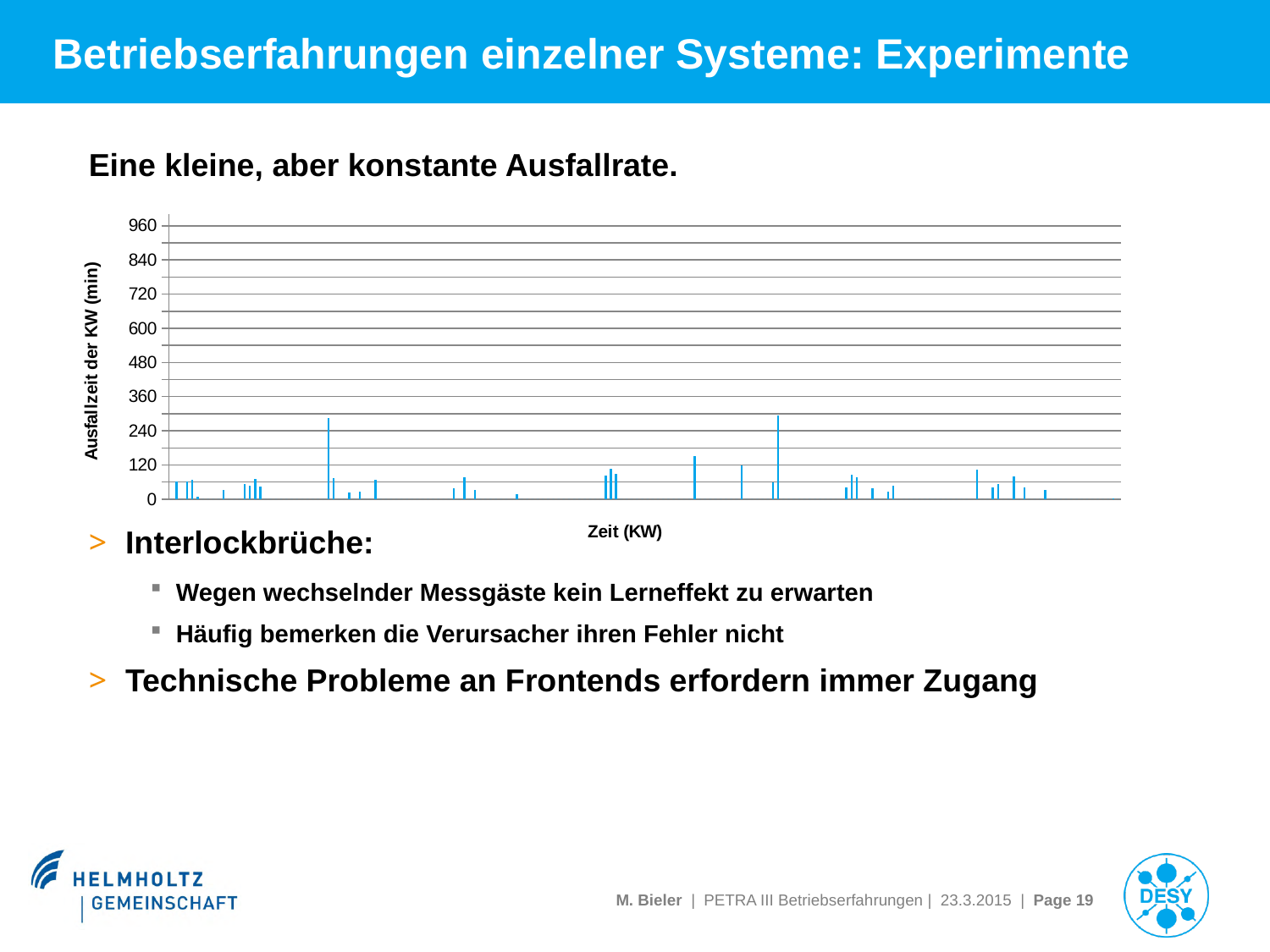
What kind of chart is shown on the slide? bar chart Are most of the bars in the chart greater or less than 120? less What is the title of the vertical axis of the chart? Ausfallzeit der KW (min) Is the value of the tallest bar in the chart greater or less than 240? greater Is the value of the tallest bar in the chart greater or less than 360? less What is the title of the horizontal axis of the chart? Zeit (KW)